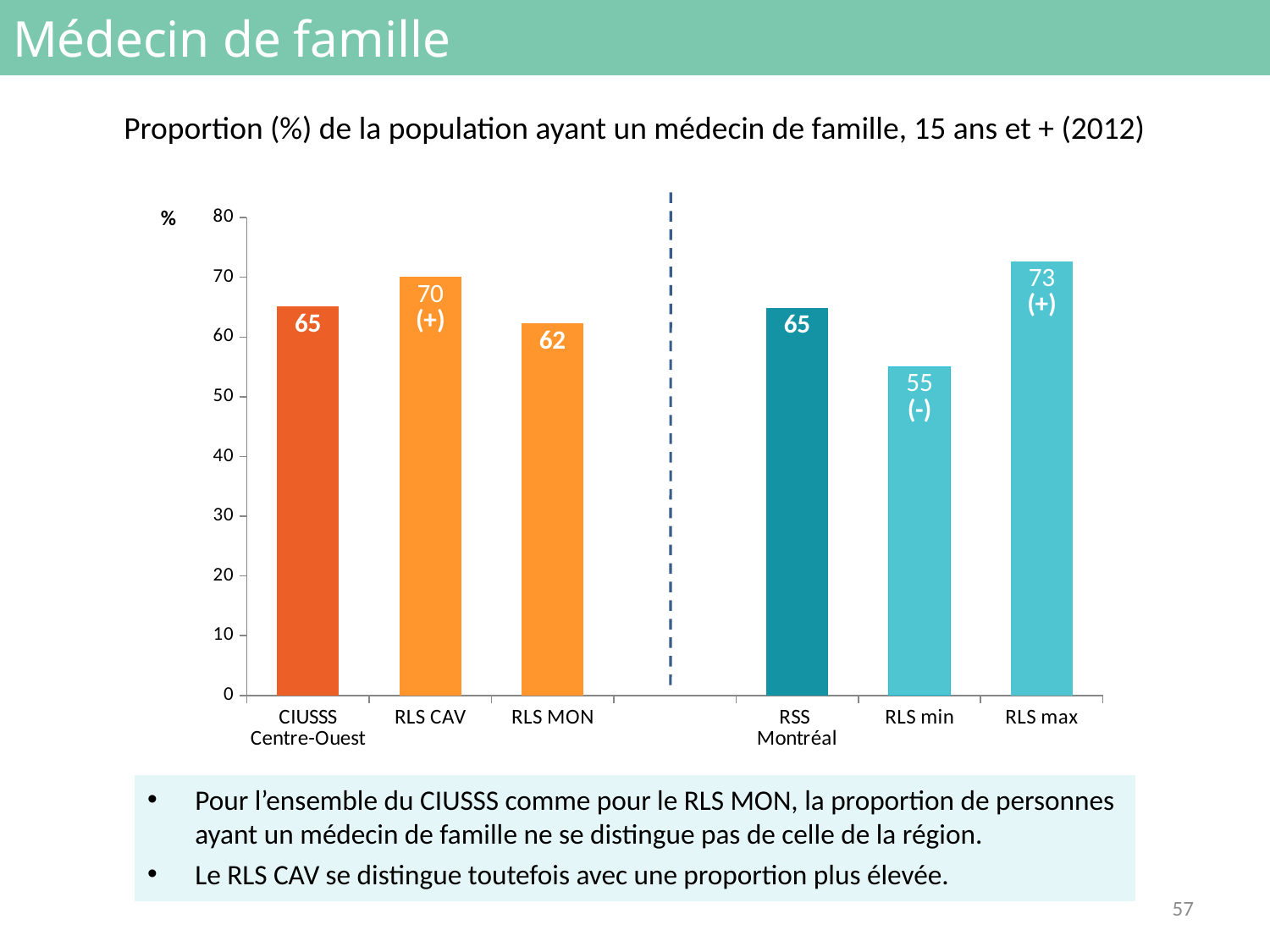
Which category has the lowest value? RLS min Which is larger, the value for RLS CAV or the value for RLS MON? RLS CAV What is the value for CIUSSS Centre-Ouest? 65 What kind of chart is shown? bar chart What is the difference between the values for RLS max and RLS min? 18 What is the title of the chart? Proportion (%) de la population ayant un médecin de famille, 15 ans et + (2012) How many categories are shown on the x axis? 6 What is the value for RLS MON? 62 What is the value for RLS CAV? 70 Is the value for RSS Montréal greater or less than 60? greater What is the value for RLS min? 55 Which category has the highest value? RLS max